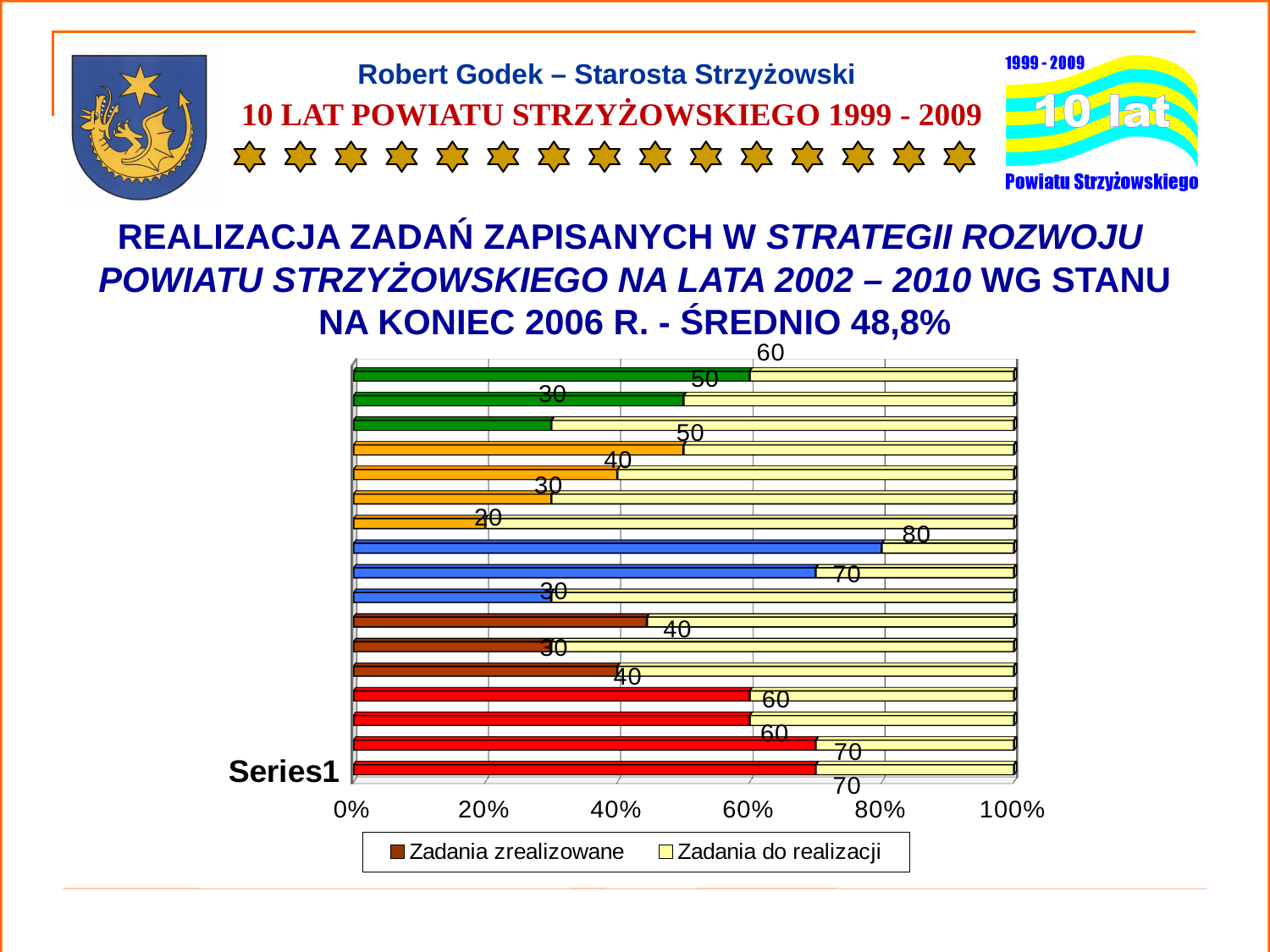
What is the lowest labelled value in the chart? 20 What are the two entries in the chart legend? Zadania zrealizowane, Zadania do realizacji What kind of chart is shown on the slide? bar chart Is the completed portion of the bottom 'Series1' bar greater or less than 60%? greater How many bars are plotted in the chart? 17 How many series does the legend list? 2 Which has the larger labelled value, the topmost bar or the bottom 'Series1' bar? the bottom 'Series1' bar What is the maximum value shown on the horizontal axis? 100% What is the labelled value of the bar marked 'Series1' at the bottom of the chart? 70 What is the highest labelled value in the chart? 80 What is the difference between the labelled value of the bottom 'Series1' bar and the topmost bar? 10 What is the labelled value of the topmost bar in the chart? 60